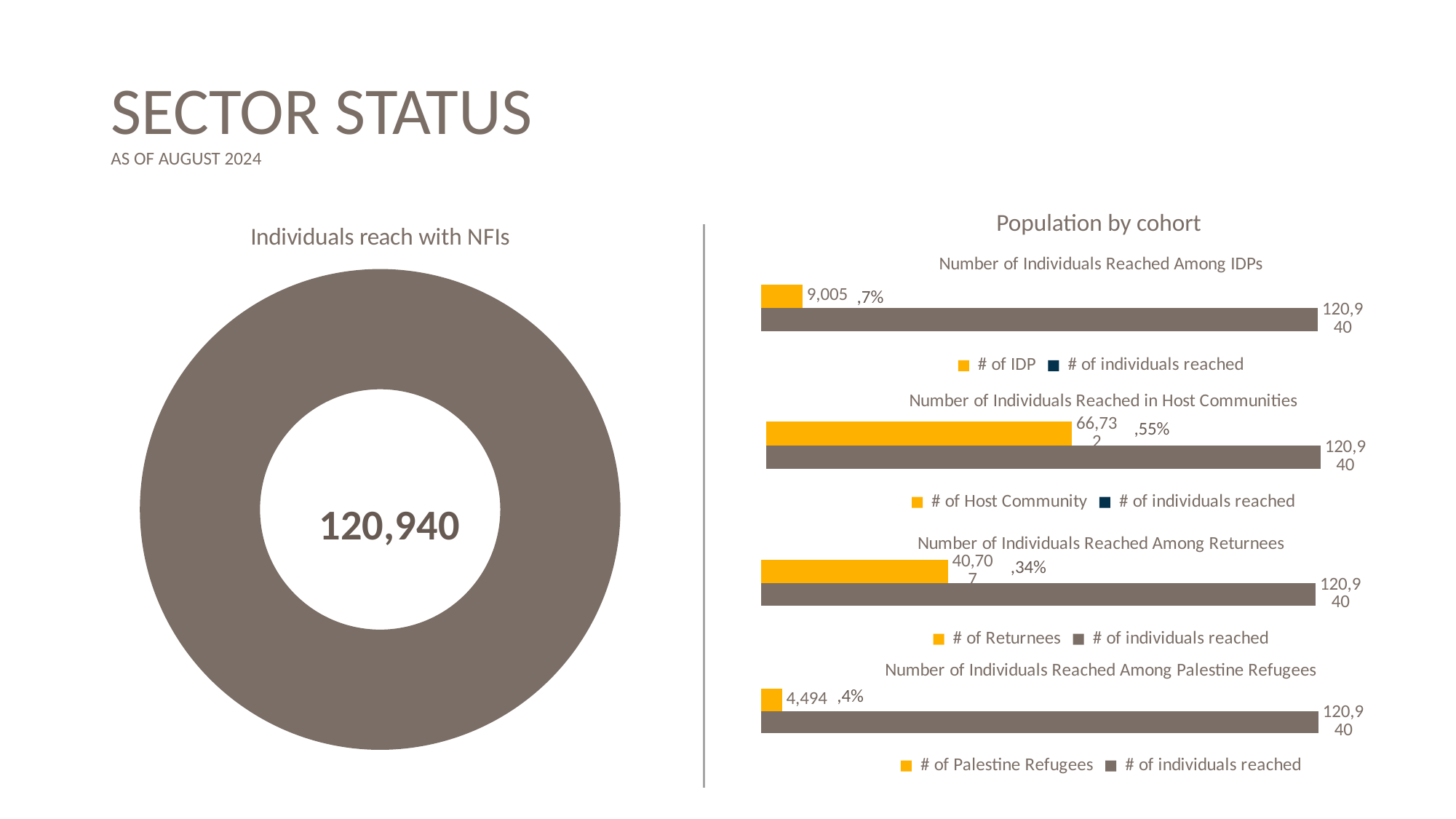
In the chart 'Number of Individuals Reached Among Palestine Refugees', what is the value for # of Palestine Refugees? 4,494 What is the difference between # of Host Community (66,732) and # of Returnees (40,707)? 26,025 In the chart 'Number of Individuals Reached Among IDPs', what is the difference between # of individuals reached and # of IDP? 111,935 In the chart 'Number of Individuals Reached in Host Communities', what percentage is shown next to the # of Host Community bar? 55% Which is larger: # of Host Community in the Host Communities chart or # of Returnees in the Returnees chart? # of Host Community In the chart 'Number of Individuals Reached Among IDPs', what is the value for # of IDP? 9,005 What value is shown in the centre of the donut chart 'Individuals reach with NFIs'? 120,940 How many series does the legend of the chart 'Number of Individuals Reached Among Returnees' list? 2 Among the four cohort charts on the right, which cohort has the lowest number of individuals reached? Palestine Refugees What kind of chart is 'Individuals reach with NFIs'? Donut chart In the chart 'Number of Individuals Reached in Host Communities', what is the value for # of Host Community? 66,732 In the chart 'Number of Individuals Reached Among Returnees', what is the value for # of Returnees? 40,707